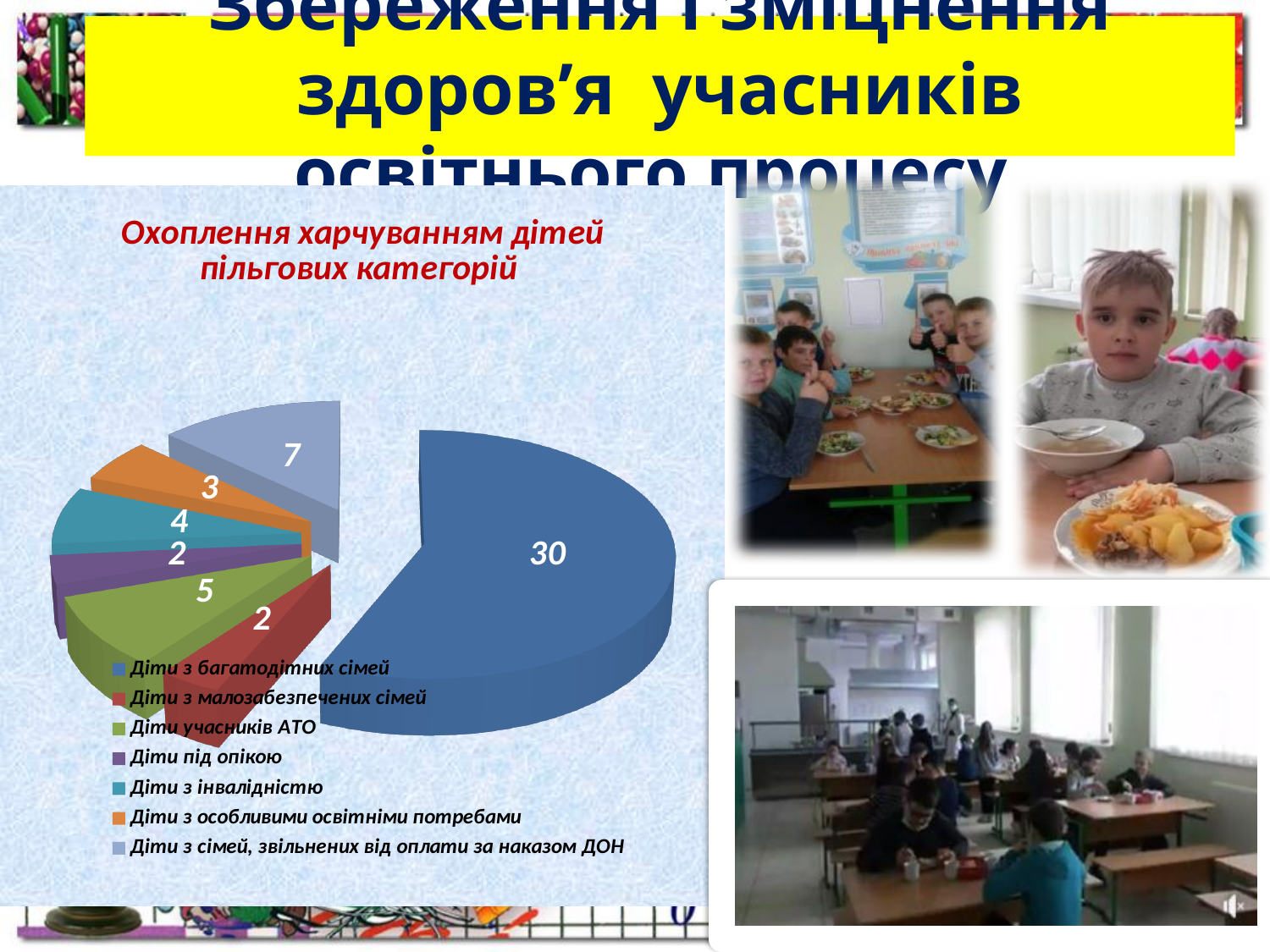
How many categories does the legend of the pie chart list? 7 Which category has the largest slice in the pie chart? Діти з багатодітних сімей What is the total of all the values shown in the pie chart? 53 What is the value for 'Діти учасників АТО' in the pie chart? 5 What is the value for 'Діти з особливими освітніми потребами' in the pie chart? 3 What kind of chart is shown on the slide? pie chart Which is larger: the value for 'Діти учасників АТО' or the value for 'Діти з інвалідністю'? Діти учасників АТО What is the difference between the values for 'Діти з багатодітних сімей' and 'Діти з сімей, звільнених від оплати за наказом ДОН'? 23 What is the value for 'Діти з сімей, звільнених від оплати за наказом ДОН' in the pie chart? 7 What is the value for 'Діти з інвалідністю' in the pie chart? 4 What is the title of the chart on the slide? Охоплення харчуванням дітей пільгових категорій What is the value for 'Діти з багатодітних сімей' in the pie chart? 30